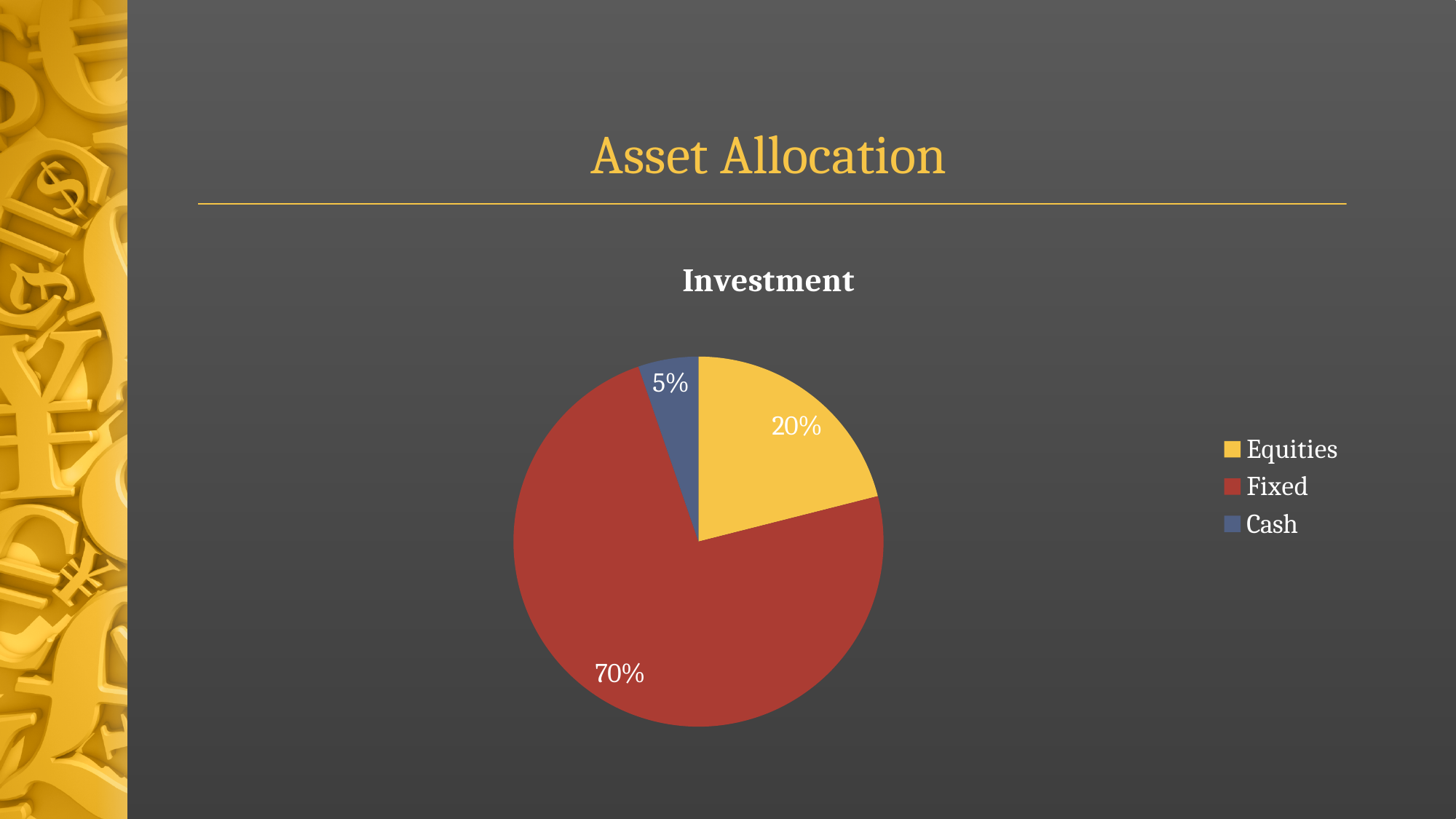
What type of chart is shown on the slide? Pie chart Which category has the largest share of the pie? Fixed What colour is the Fixed slice? Red Which is larger, the Equities slice or the Cash slice? Equities What percentage of the pie is Fixed? 70% What percentage of the pie is Equities? 20% What is the chart's title? Investment How many categories does the legend list? 3 What percentage of the pie is Cash? 5% What is the difference in percentage points between Equities and Cash? 15 What is the difference in percentage points between Fixed and Equities? 50 Which category has the smallest share of the pie? Cash